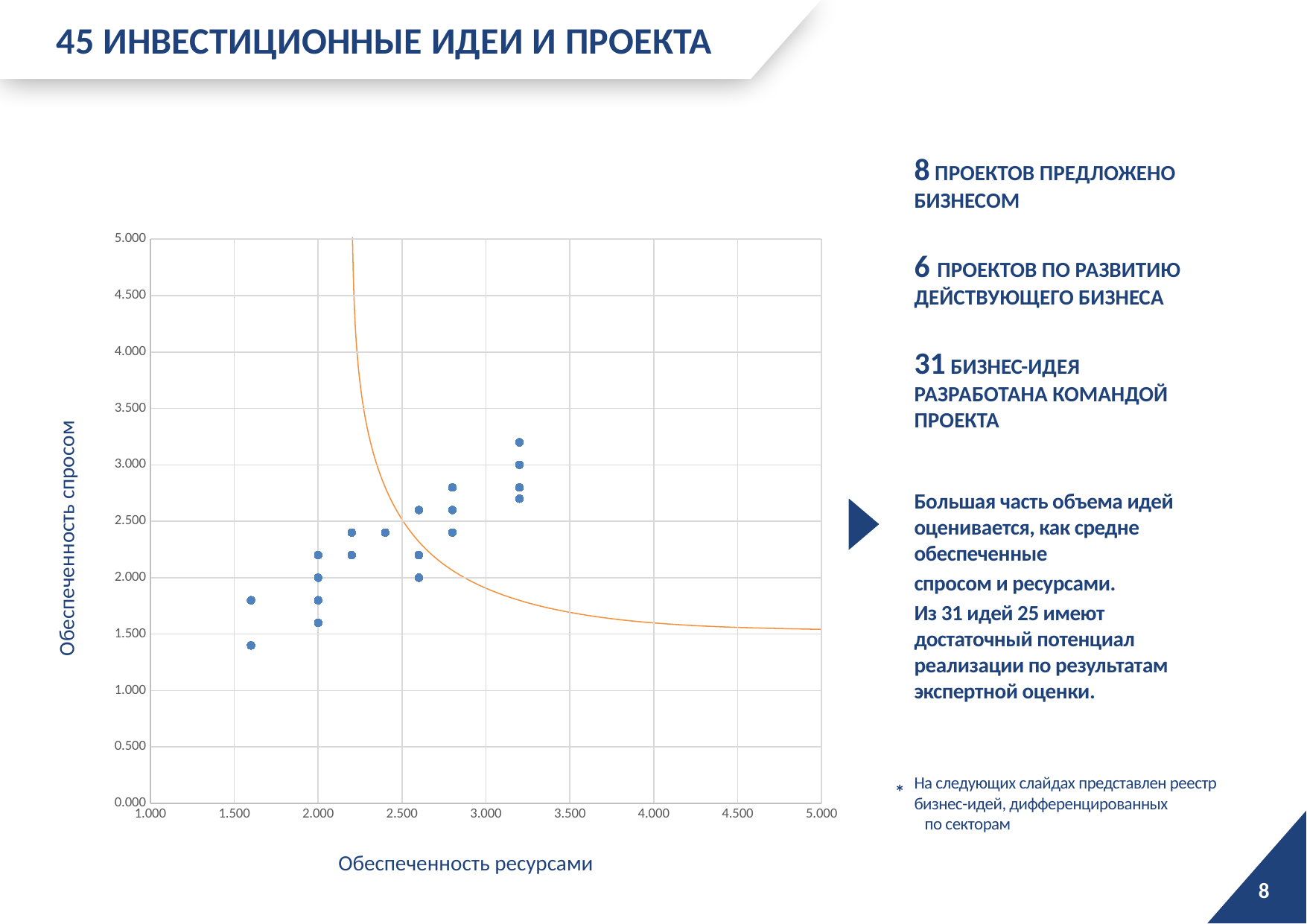
Is the smallest horizontal-axis value among the plotted points greater or less than 1.500? greater Do the plotted points generally rise or fall as the horizontal-axis value increases? rise What is the title of the horizontal axis of the chart? Обеспеченность ресурсами Are any of the plotted points above 3.500 on the vertical axis? No What kind of chart is shown on the slide? scatter chart Is the lowest plotted point's value on the vertical axis greater or less than 1.500? less What is the maximum value shown on the vertical axis of the chart? 5.000 What is the title of the vertical axis of the chart? Обеспеченность спросом